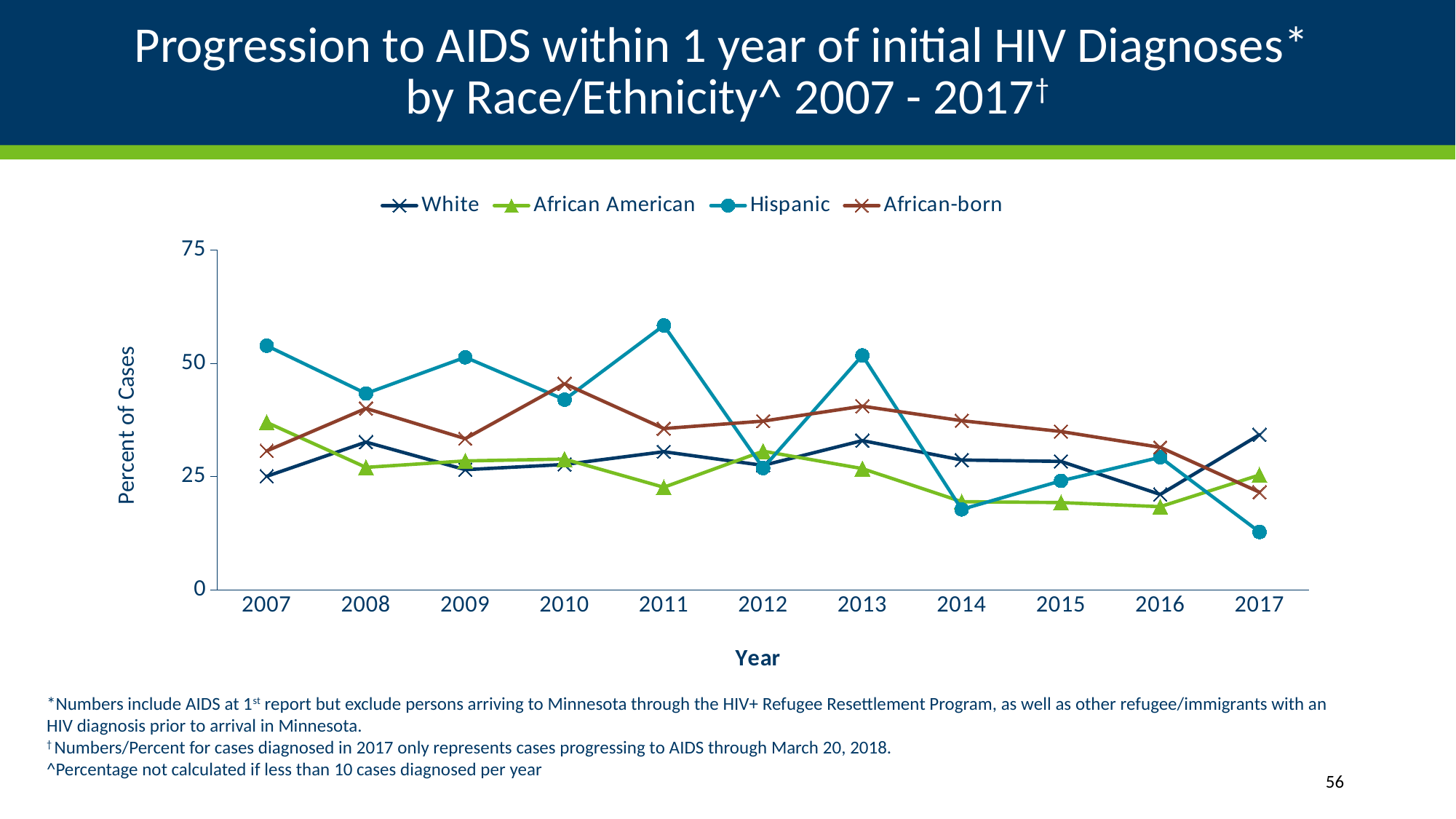
Is the value for African-born in 2010 greater or less than 50? less In which year does the Hispanic series reach its highest value? 2011 How many series does the legend list? 4 Is the value for Hispanic in 2011 greater or less than 50? greater Is the value for African American in 2014 greater or less than 25? less What kind of chart is shown on the slide? line chart In 2013, which is larger: the value for Hispanic or the value for African American? Hispanic In which year does the Hispanic series reach its lowest value? 2017 What is the label on the y axis? Percent of Cases How many years are plotted along the x axis? 11 Which series has the highest value in 2011? Hispanic